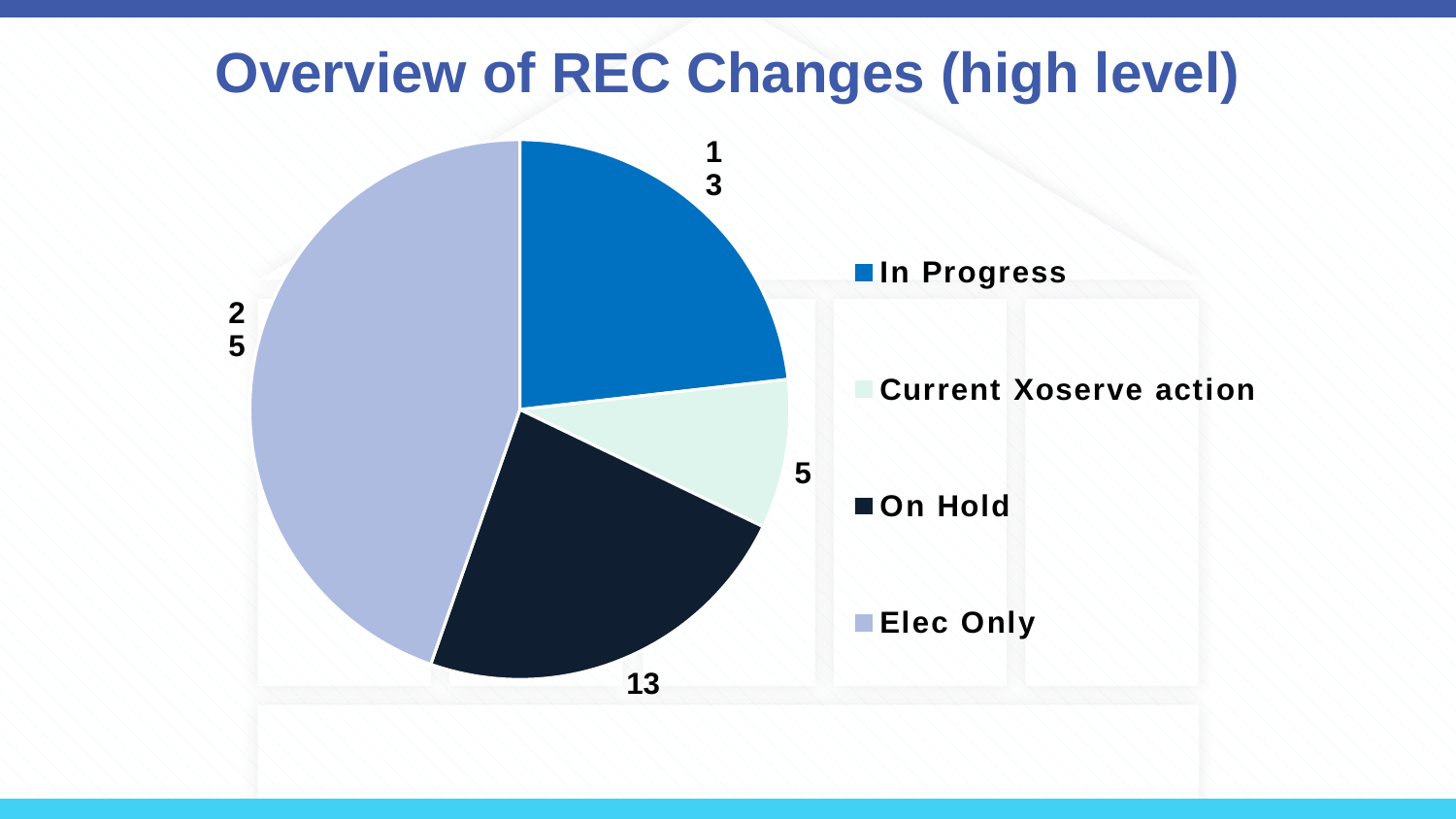
Which category has the smallest slice of the pie? Current Xoserve action What is the value for On Hold? 13 What is the title of the slide containing the chart? Overview of REC Changes (high level) What type of chart is shown on the slide? Pie chart What is the difference between the value for Elec Only and the value for Current Xoserve action? 20 Which is larger, the value for Elec Only or the value for On Hold? Elec Only What is the value for In Progress? 13 How many entries does the legend list? 4 Which category has the largest slice of the pie? Elec Only What is the value for Current Xoserve action? 5 How many categories does the pie chart have? 4 What is the value for Elec Only? 25